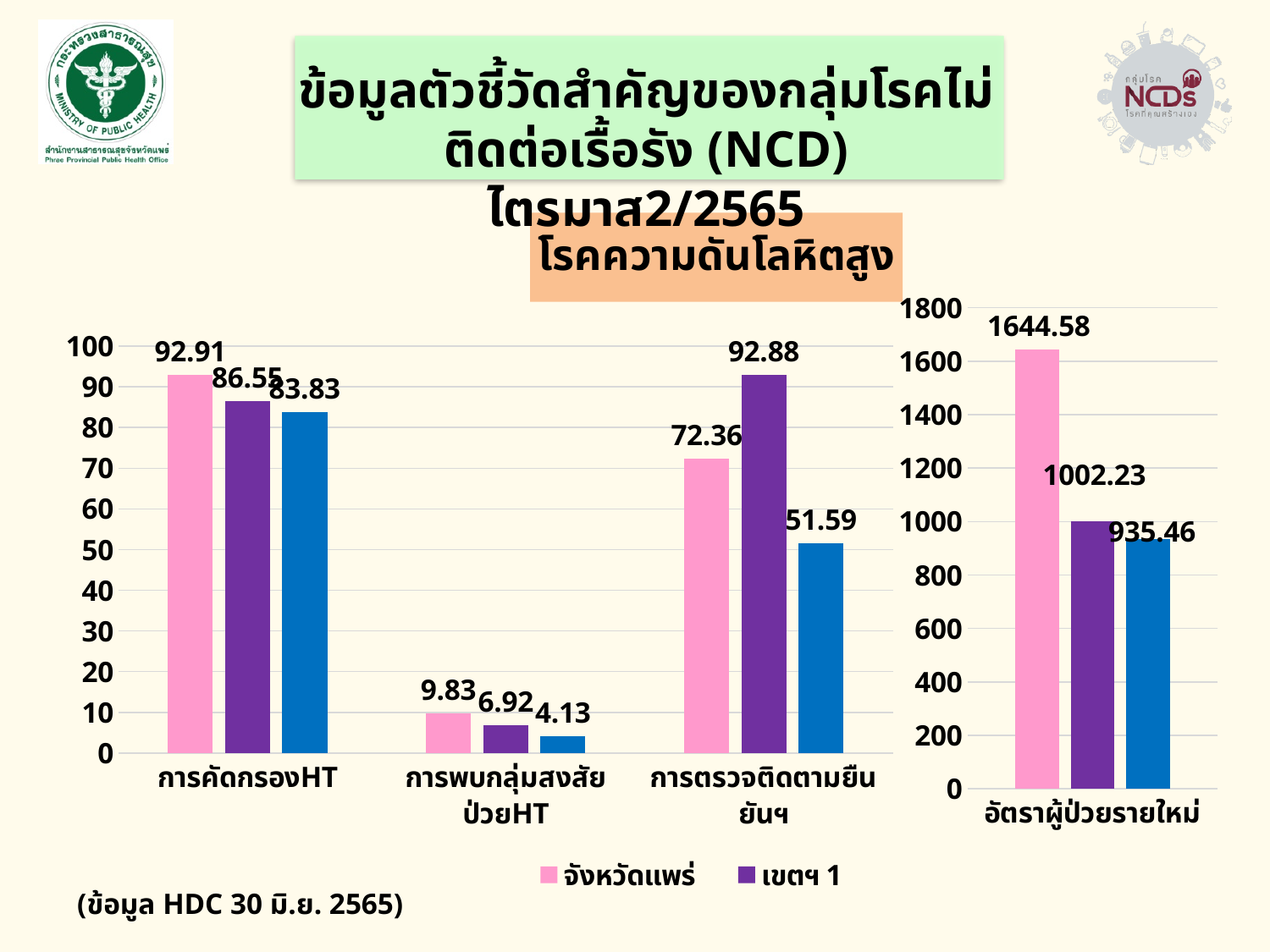
In the right chart (อัตราผู้ป่วยรายใหม่), what is the value for จังหวัดแพร่? 1644.58 How many categories are shown on the x axis of the left chart? 3 In the left chart, which category has the highest value for เขตฯ 1? การตรวจติดตามยืนยันฯ In the left chart, what is the value for เขตฯ 1 in the การตรวจติดตามยืนยันฯ category? 92.88 In the left chart, what is the difference between จังหวัดแพร่ and เขตฯ 1 in the การคัดกรองHT category? 6.36 In the left chart, what is the value for จังหวัดแพร่ in the การพบกลุ่มสงสัยป่วยHT category? 9.83 In the right chart, what is the difference between the จังหวัดแพร่ value and the เขตฯ 1 value? 642.35 In the left chart, which category has the lowest value for จังหวัดแพร่? การพบกลุ่มสงสัยป่วยHT In the right chart (อัตราผู้ป่วยรายใหม่), what is the value for เขตฯ 1? 1002.23 In the left chart, for การตรวจติดตามยืนยันฯ, which is larger: จังหวัดแพร่ or เขตฯ 1? เขตฯ 1 What type of chart is the right chart (อัตราผู้ป่วยรายใหม่)? Bar chart In the left chart, what is the value for จังหวัดแพร่ in the การคัดกรองHT category? 92.91